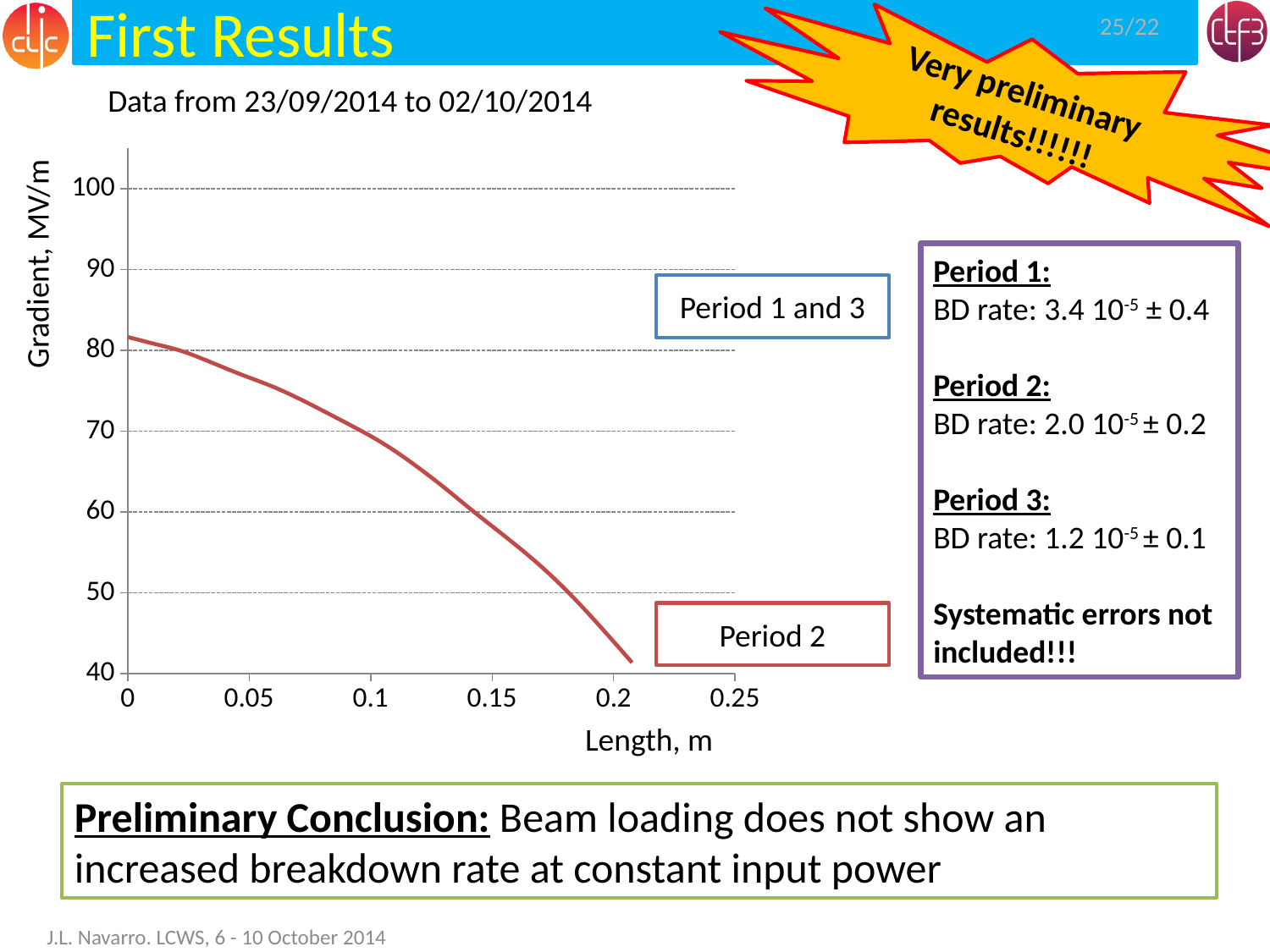
Is the gradient at a length of 0.05 m larger or smaller than the gradient at 0.15 m? larger What is the label of the y axis of the chart? Gradient, MV/m At which length is the plotted gradient highest? 0 Is the gradient at a length of 0.05 m greater or less than 80 MV/m? less Does the gradient rise or fall as length increases along the x axis? fall Is the gradient at a length of 0.2 m greater or less than 50 MV/m? greater What is the label of the x axis of the chart? Length, m Is the gradient at a length of 0.2 m greater or less than 40 MV/m? greater What kind of chart is shown on the slide? line chart What is the highest value shown on the y axis of the chart? 100